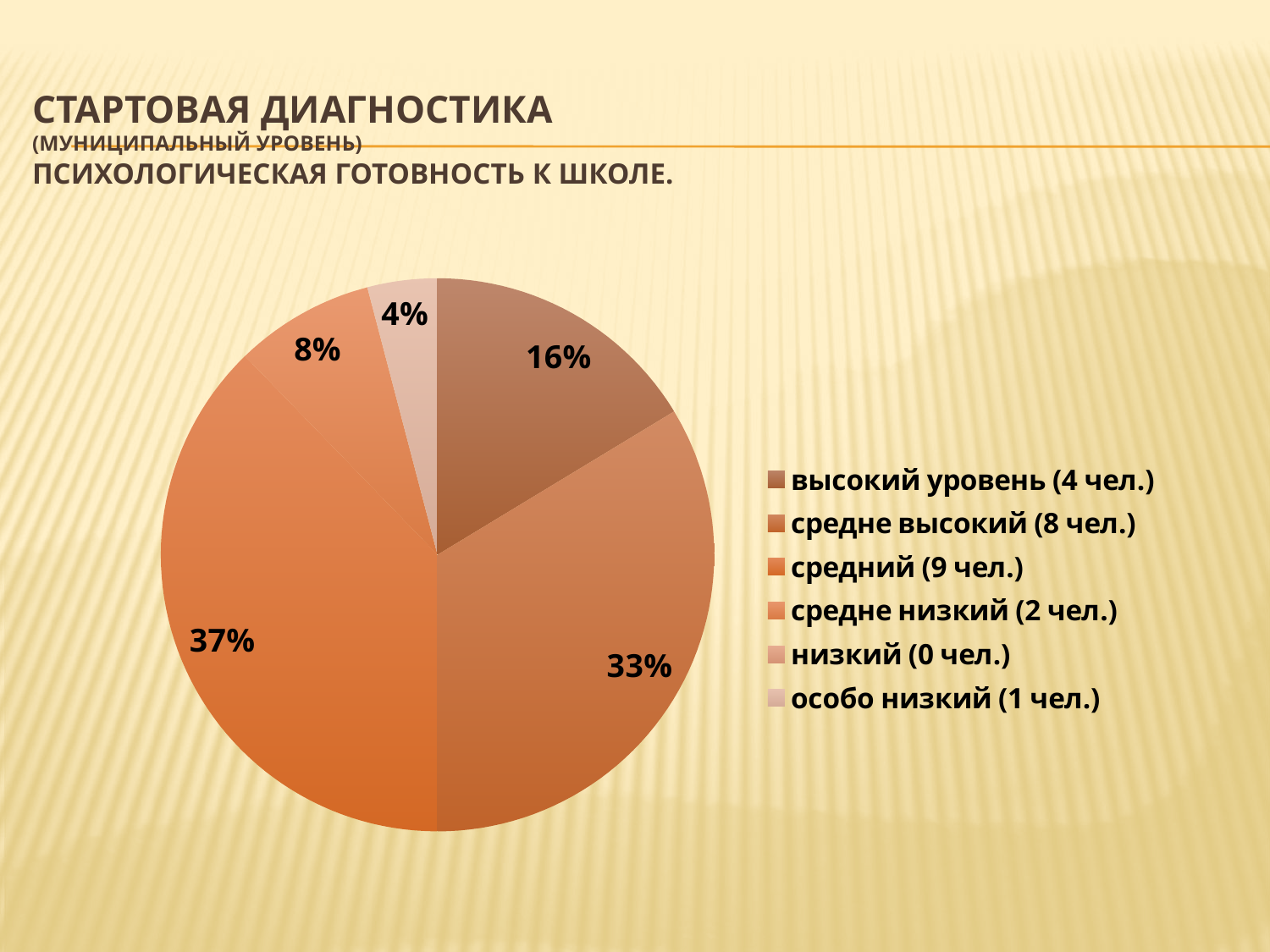
How many entries does the legend list? 6 What percentage share does the slice for "высокий уровень (4 чел.)" have? 16% What percentage share does the slice for "средний (9 чел.)" have? 37% What is the difference in percentage points between the "средний" slice and the "средне высокий" slice? 4 Which slice is larger: "средне высокий (8 чел.)" or "высокий уровень (4 чел.)"? средне высокий (8 чел.) What percentage share does the slice for "особо низкий (1 чел.)" have? 4% How many people are in the "низкий" category according to the legend? 0 What kind of chart is shown on the slide? pie chart Which category with a visible slice has the smallest share of the pie? особо низкий (1 чел.) Which category has the largest slice of the pie? средний (9 чел.) What is the combined percentage of the "высокий уровень" and "средне высокий" slices? 49%